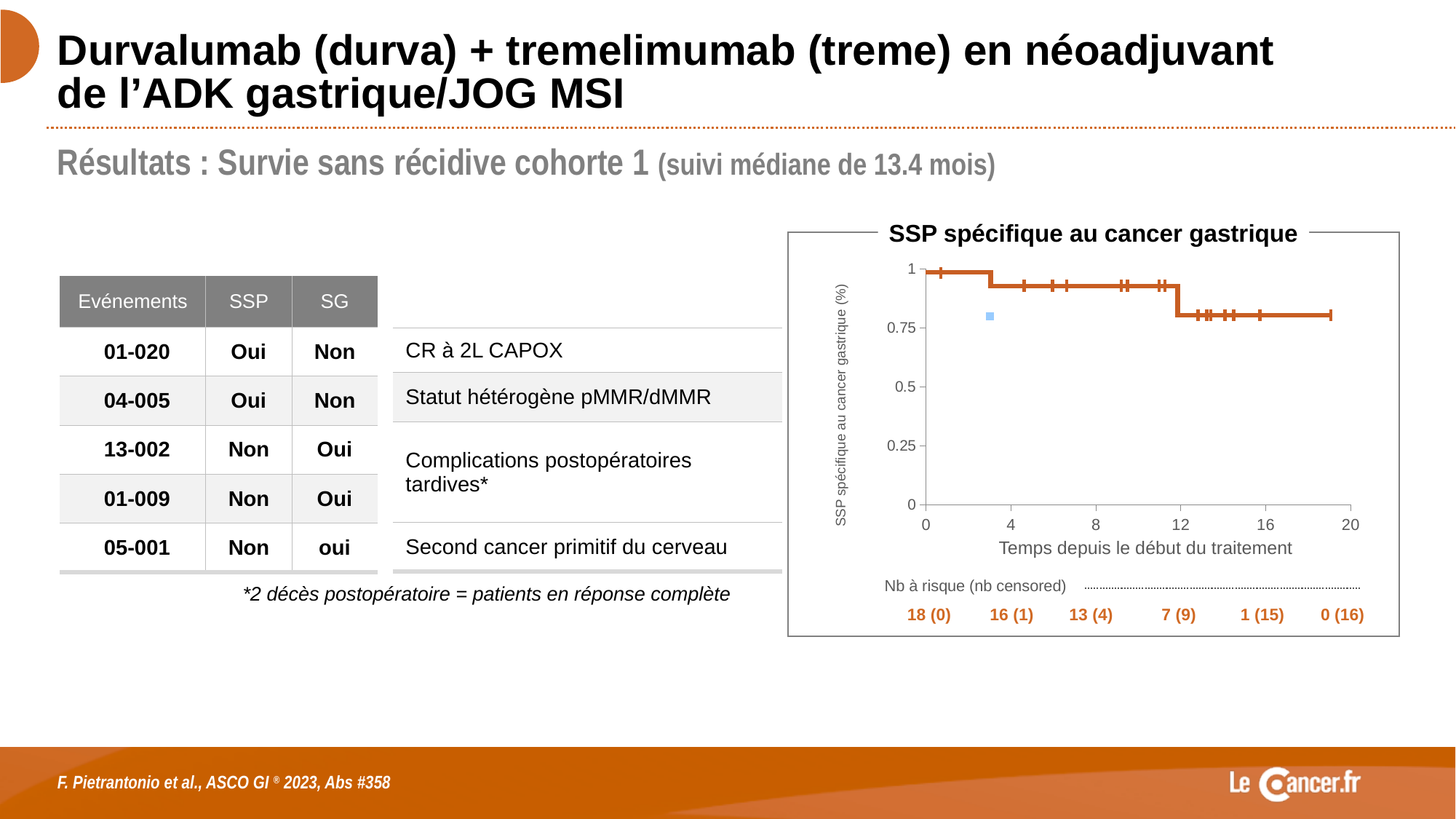
In the survival chart, how many patients are at risk at 12 months? 7 In the survival chart, what is the difference between the number at risk at 0 months and at 12 months? 11 In the survival chart, is the survival value at 16 months greater or less than 0.75? greater What is the label of the x axis of the survival chart? Temps depuis le début du traitement What kind of chart is shown under the title "SSP spécifique au cancer gastrique"? Line chart (Kaplan-Meier survival curve) In the survival chart, is the survival value at 8 months greater or less than 0.75? greater In the survival chart, at which time point is the number at risk lowest? 20 months In the survival chart, does the survival curve rise or fall over time? fall In the survival chart, how many patients are at risk at 8 months? 13 In the survival chart, how many patients are censored at 20 months? 16 What is the title of the chart on the right of the slide? SSP spécifique au cancer gastrique In the survival chart, how many patients are at risk at time 0? 18